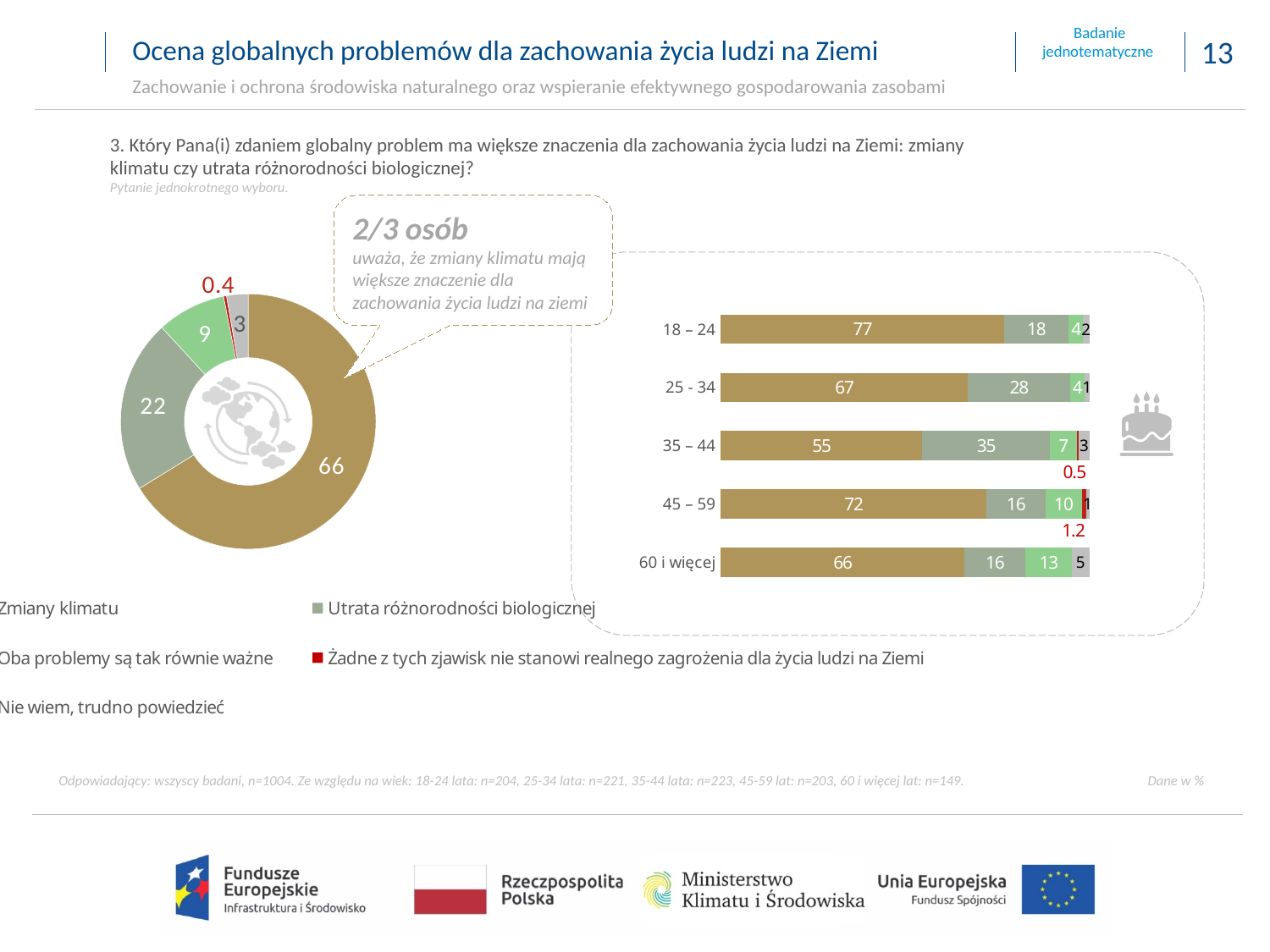
In the donut chart on the left, what is the value for 'Utrata różnorodności biologicznej'? 22 In the bar chart on the right, what is the value for 'Utrata różnorodności biologicznej' in the 35 – 44 age group? 35 In the donut chart on the left, which category has the largest share? Zmiany klimatu In the bar chart on the right, which age group has the lowest value for 'Zmiany klimatu'? 35 – 44 In the bar chart on the right, which age group has the highest value for 'Zmiany klimatu'? 18 – 24 In the bar chart on the right, what is the value for 'Zmiany klimatu' in the 18 – 24 age group? 77 In the donut chart on the left, what is the value for 'Żadne z tych zjawisk nie stanowi realnego zagrożenia dla życia ludzi na Ziemi'? 0.4 In the donut chart on the left, what percentage of respondents chose 'Zmiany klimatu'? 66 What type of chart is the chart on the right of the slide? Stacked bar chart In the bar chart on the right, what is the difference between the 'Zmiany klimatu' values for the 18 – 24 and 35 – 44 age groups? 22 In the bar chart on the right, what is the value for 'Oba problemy są tak równie ważne' in the 60 i więcej age group? 13 How many age groups are shown in the bar chart on the right? 5